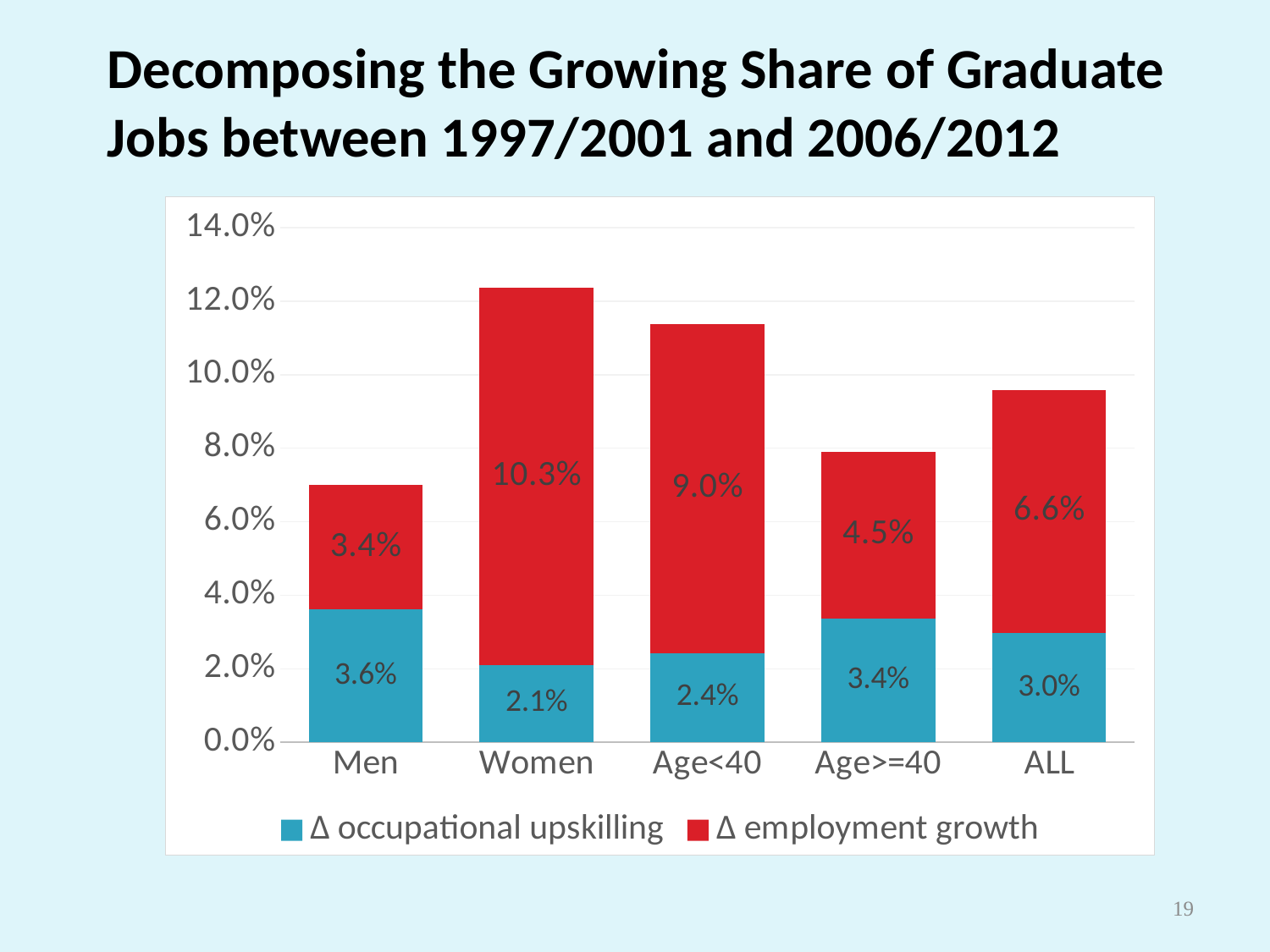
What is the Δ occupational upskilling value for ALL? 3.0% How many categories are shown on the x axis? 5 What is the Δ occupational upskilling value for Men? 3.6% Which is larger, the Δ occupational upskilling value for Men or for Age<40? Men What is the total height of the stacked bar for Women? 12.4% How many series does the legend list? 2 What is the total height of the stacked bar for Men? 7.0% What is the Δ employment growth value for Age>=40? 4.5% Which category has the highest Δ employment growth value? Women Which category has the lowest Δ occupational upskilling value? Women What is the Δ employment growth value for Women? 10.3% What is the difference between the Δ employment growth values for Age<40 and Age>=40? 4.5%